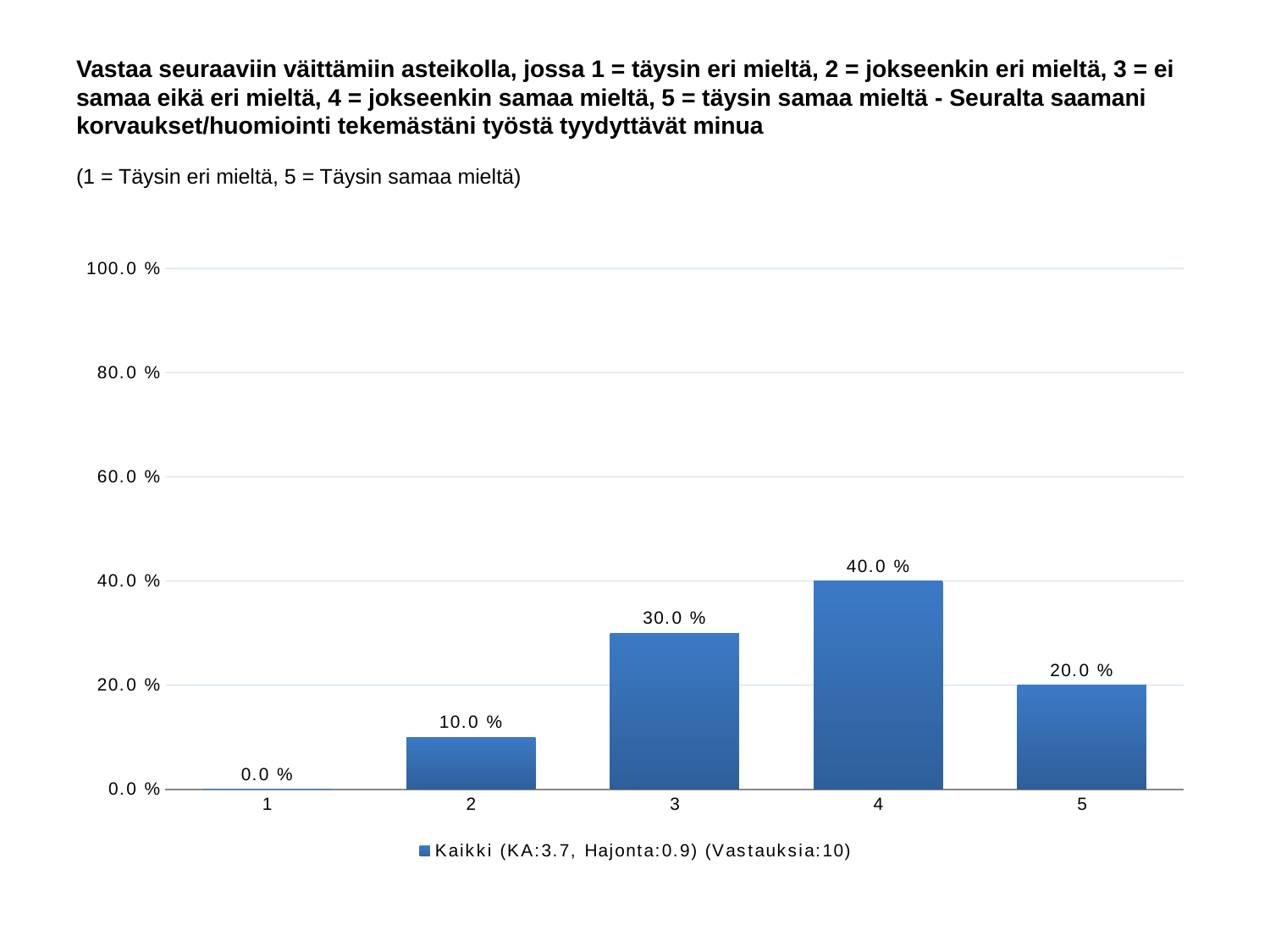
What is the difference between the values for category 4 and category 3? 10.0 % What is the value for category 2? 10.0 % What is the difference between the values for category 5 and category 2? 10.0 % Which category has the lowest value? 1 What is the value for category 5? 20.0 % How many series does the legend list? 1 What is the legend entry for the series? Kaikki (KA:3.7, Hajonta:0.9) (Vastauksia:10) Which is larger, the value for category 3 or the value for category 5? 3 What is the value for category 4? 40.0 % Which category has the highest value? 4 How many categories are shown on the x axis? 5 What kind of chart is shown on the slide? bar chart